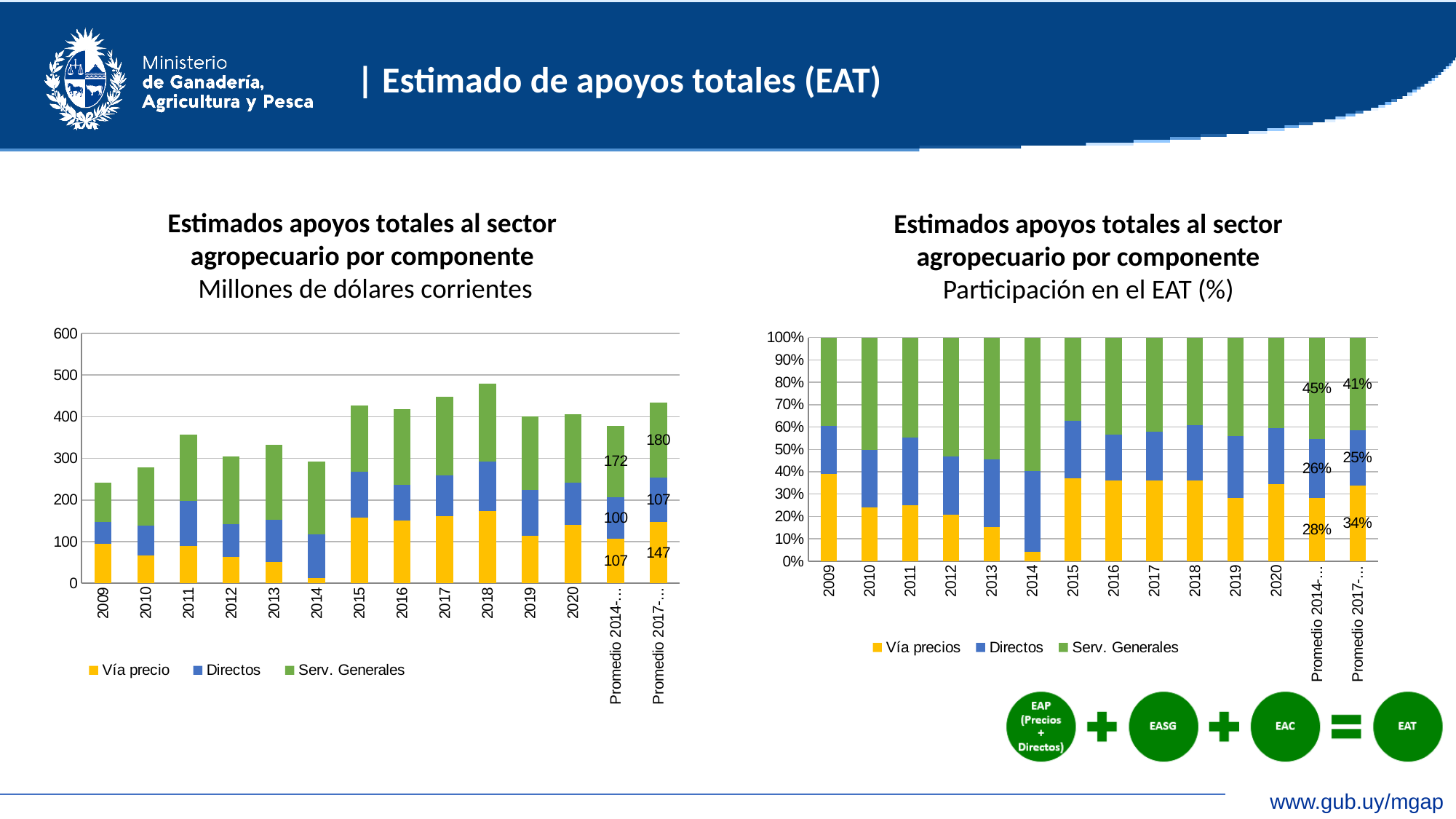
In the left chart (Millones de dólares corrientes), which year has the highest total bar? 2018 In the right chart (Participación en el EAT (%)), what is the share of Serv. Generales for the Promedio 2014-… bar? 45% How many series does the legend of the left chart list? 3 In the left chart (Millones de dólares corrientes), what is the value of Vía precio for the Promedio 2017-… bar? 147 What kind of chart is the left chart (Millones de dólares corrientes)? Stacked bar chart In the right chart (Participación en el EAT (%)), what is the share of Vía precios for the Promedio 2017-… bar? 34% In the left chart (Millones de dólares corrientes), what is the difference in Serv. Generales between the Promedio 2017-… bar and the Promedio 2014-… bar? 8 In the left chart (Millones de dólares corrientes), is the total for 2015 greater or less than 400? greater In the left chart (Millones de dólares corrientes), what is the value of Serv. Generales for the Promedio 2014-… bar? 172 In the left chart (Millones de dólares corrientes), which year has the lowest total bar? 2009 In the right chart (Participación en el EAT (%)), which year has the lowest Vía precios share? 2014 In the left chart (Millones de dólares corrientes), what is the total of the Promedio 2017-… stacked bar? 434